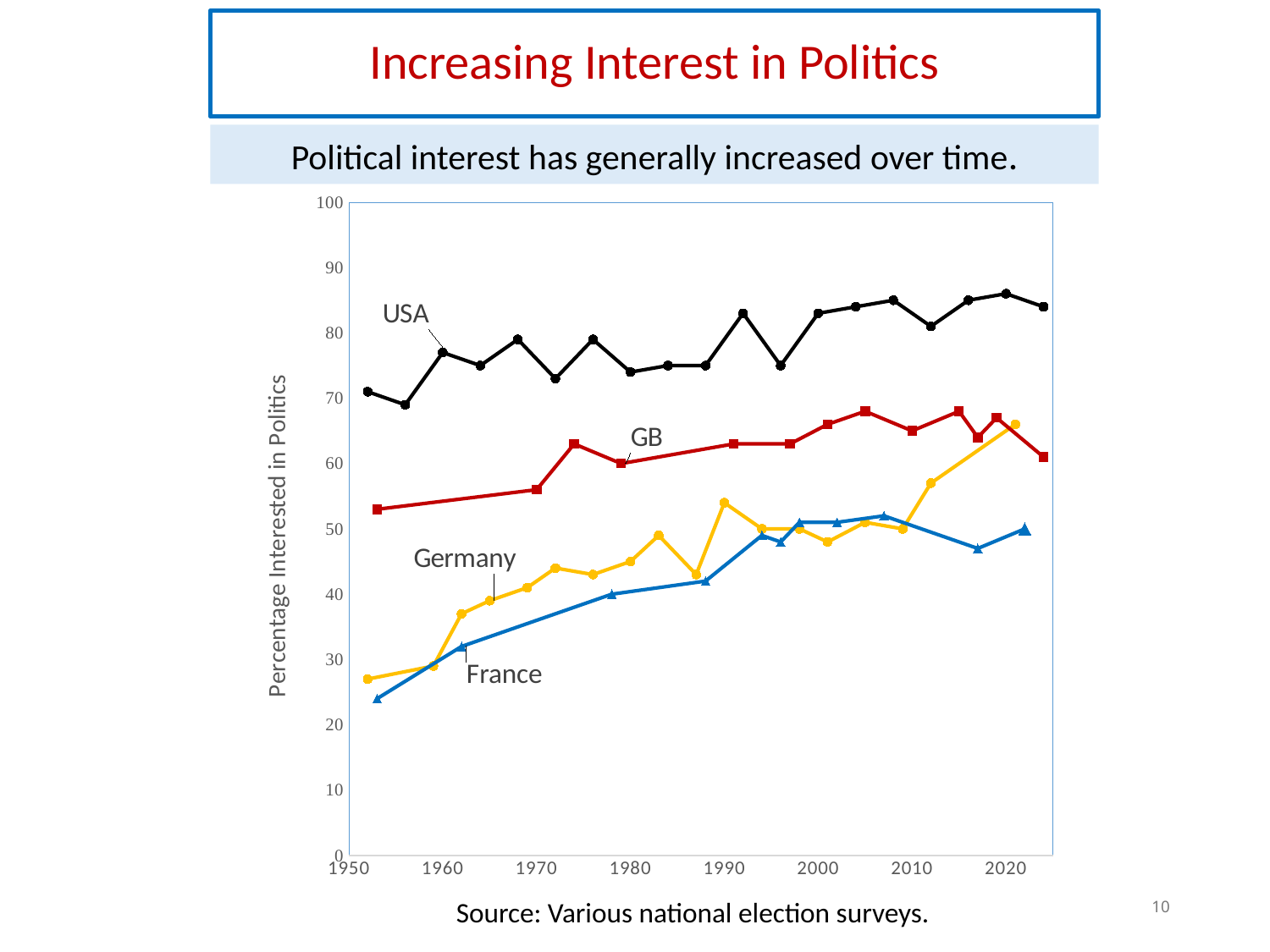
Does the value for France generally rise or fall from 1950 to 2020? rise Is the value for France in the early 1950s greater or less than 30? less Which country has the highest percentage interested in politics throughout the chart? USA What is the label on the vertical axis of the chart? Percentage Interested in Politics Is the value for Germany at its last point (around 2022) greater or less than 60? greater Is the value for the USA in the early 1950s greater or less than 60? greater Which country has the lowest percentage interested in politics at the start of the chart (early 1950s)? France Which is larger around 1990: the value for Germany or the value for France? Germany What kind of chart is shown on the slide? line chart How many countries (series) are plotted on the chart? 4